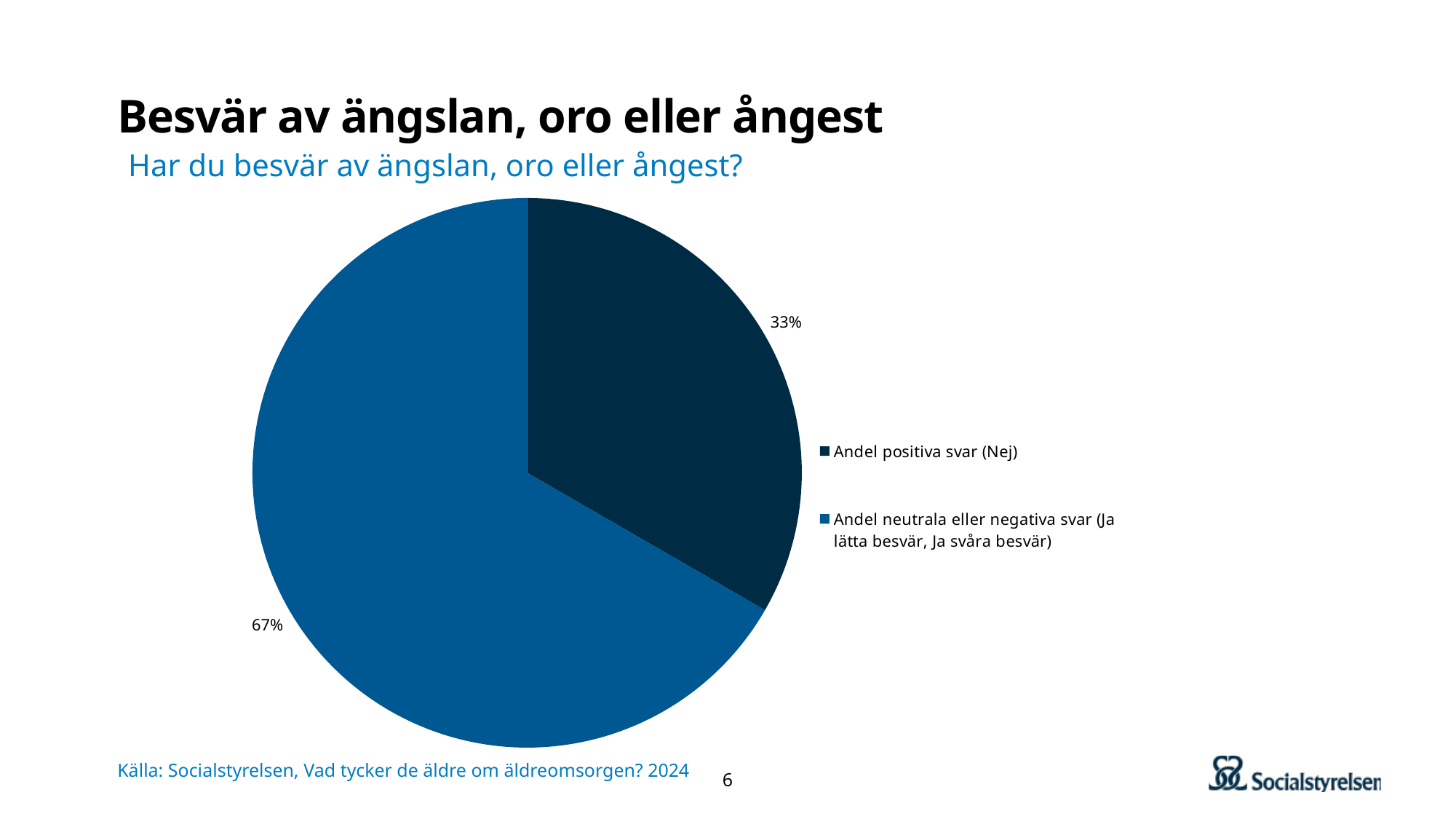
Which slice of the pie is the largest? Andel neutrala eller negativa svar (Ja lätta besvär, Ja svåra besvär) What share of the pie is labelled "Andel neutrala eller negativa svar (Ja lätta besvär, Ja svåra besvär)"? 67% Is the share for "Andel positiva svar (Nej)" greater or less than 50%? less What question is shown as the chart's subtitle? Har du besvär av ängslan, oro eller ångest? How many entries does the legend list? 2 What share of the pie is labelled "Andel positiva svar (Nej)"? 33% Which legend entry is shown in the darker navy colour? Andel positiva svar (Nej) Which is larger: the share for "Andel positiva svar (Nej)" or the share for "Andel neutrala eller negativa svar"? Andel neutrala eller negativa svar How many slices does the pie chart have? 2 What is the difference in percentage points between the two slices of the pie? 34 Which slice of the pie is the smallest? Andel positiva svar (Nej) What kind of chart is shown on the slide? pie chart